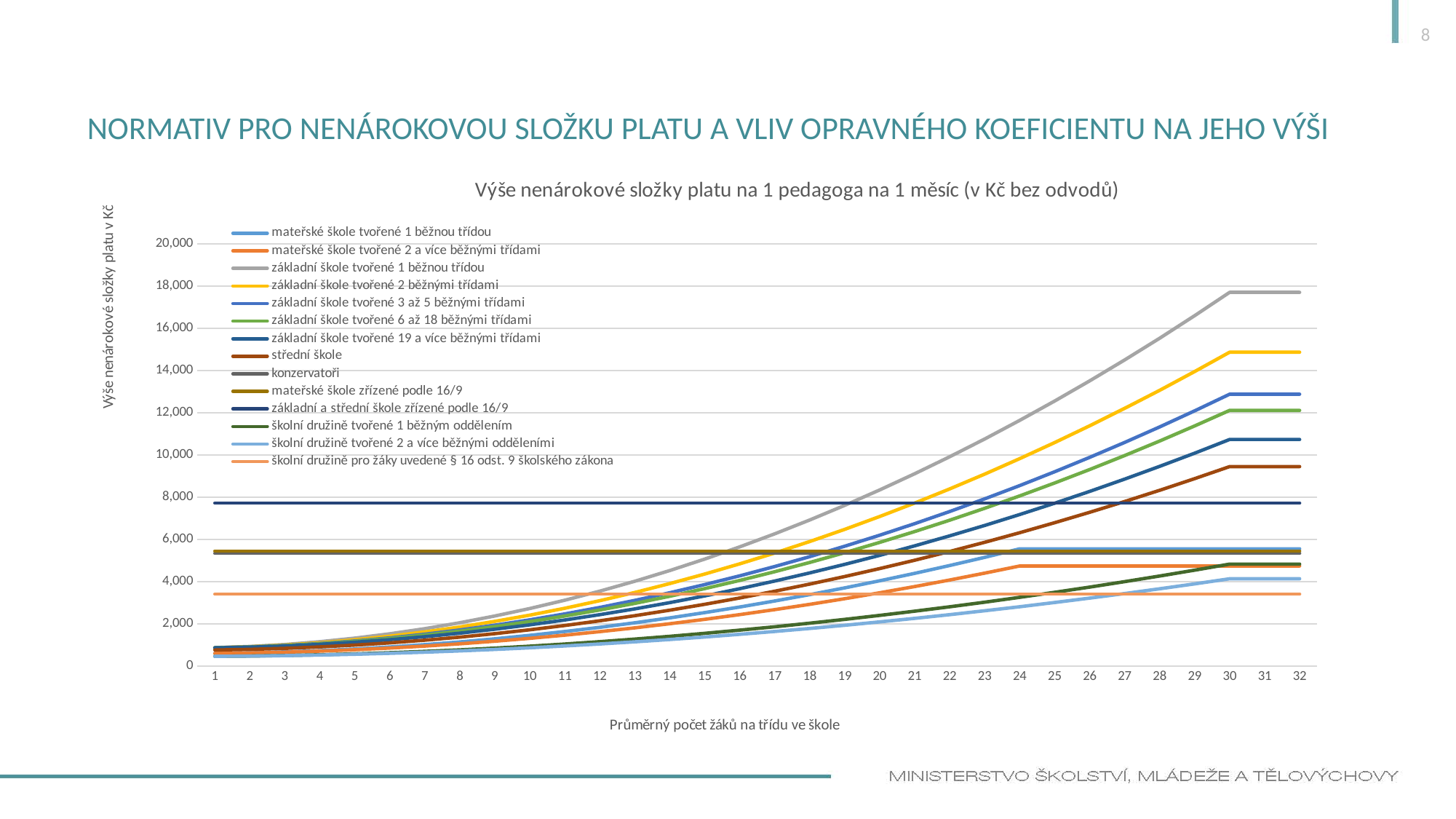
At 32 pupils per class, which is larger: 'základní škole tvořené 1 běžnou třídou' or 'základní škole tvořené 2 běžnými třídami'? základní škole tvořené 1 běžnou třídou Is the value for 'základní škole tvořené 1 běžnou třídou' at 32 pupils greater or less than 16,000? greater What is the title of the chart? Výše nenárokové složky platu na 1 pedagoga na 1 měsíc (v Kč bez odvodů) Which series has the highest value at 32 pupils per class? základní škole tvořené 1 běžnou třídou Which series has the lowest value at 32 pupils per class? školní družině pro žáky uvedené § 16 odst. 9 školského zákona Does the value for 'základní škole tvořené 1 běžnou třídou' rise or fall as the number of pupils increases from 1 to 30? rise How many values are shown on the x axis (Průměrný počet žáků na třídu ve škole)? 32 Is the value for 'základní a střední škole zřízené podle 16/9' greater or less than 8,000? less Is the value for 'školní družině pro žáky uvedené § 16 odst. 9 školského zákona' greater or less than 4,000? less What is the label of the x axis? Průměrný počet žáků na třídu ve škole What kind of chart is shown on the slide? line chart How many series does the legend list? 14